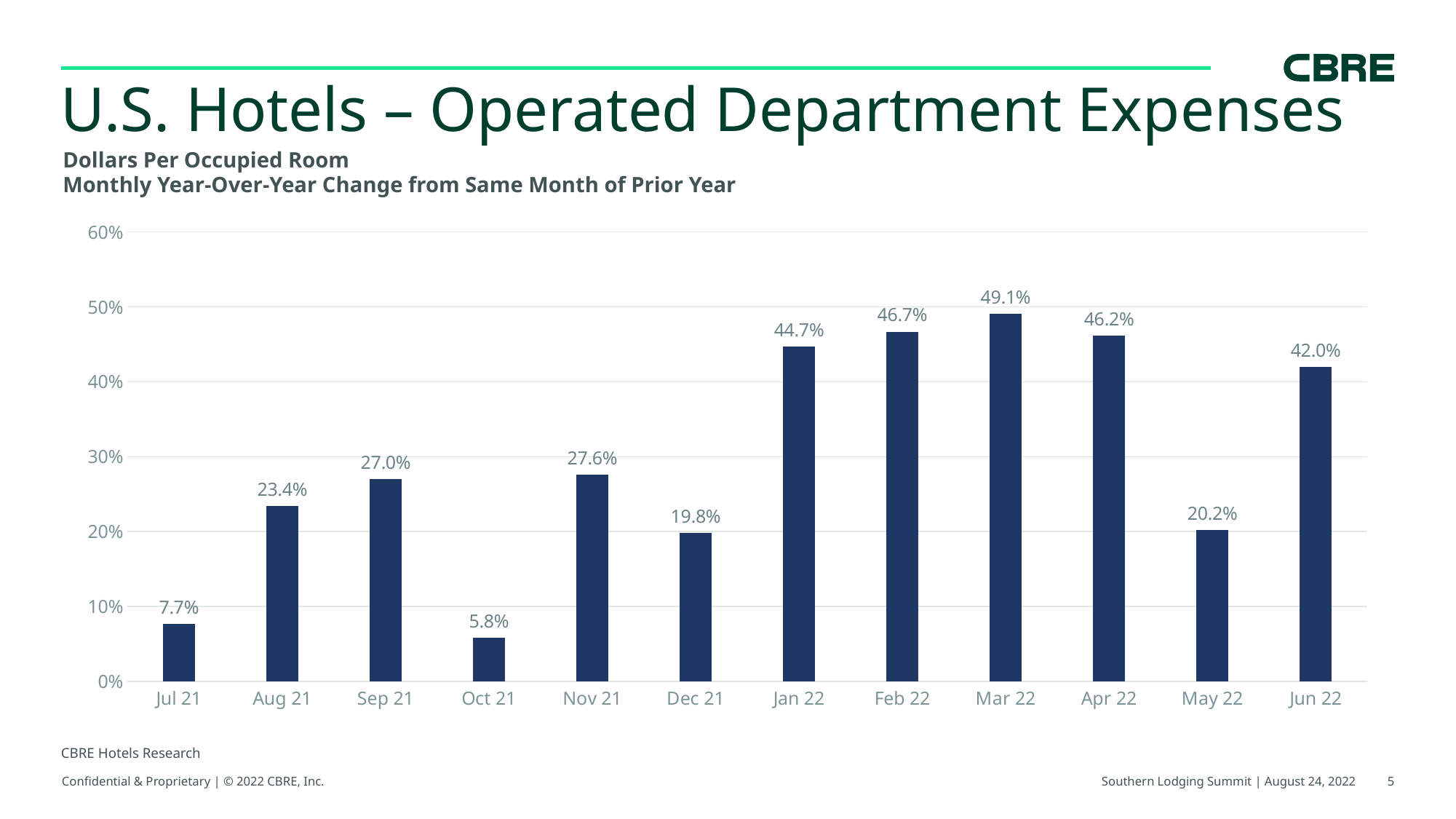
Which is larger, the value for Sep 21 or the value for Nov 21? Nov 21 Do the values rise or fall from Dec 21 to Mar 22? Rise What is the year-over-year change for Mar 22? 49.1% What is the difference between the values for Jun 22 and May 22? 21.8% Is the value for Jan 22 greater or less than 40%? greater Which month has the lowest year-over-year change? Oct 21 How many months are shown on the x axis? 12 Which month has the highest year-over-year change? Mar 22 What is the source cited below the chart? CBRE Hotels Research What is the value shown for Dec 21? 19.8% What is the year-over-year change for Oct 21? 5.8% What kind of chart is shown on the slide? Bar chart